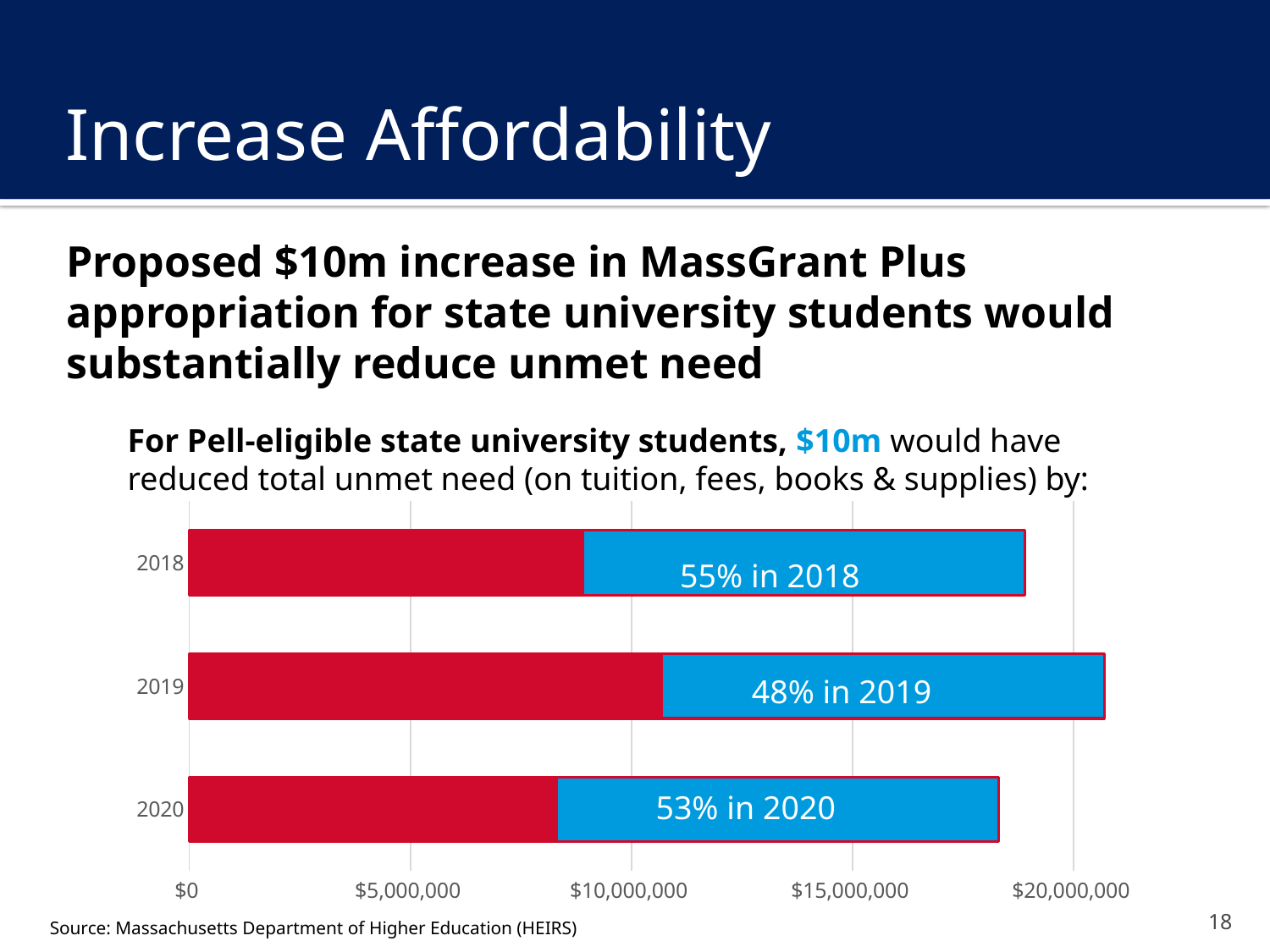
How many years are plotted in the chart? 3 Which year has the highest labelled percentage reduction? 2018 Which year has the lowest labelled percentage reduction? 2019 Is the red segment for 2020 greater or less than $10,000,000? less What percentage reduction in unmet need is labelled for 2019? 48% What is the highest value shown on the horizontal axis? $20,000,000 What percentage reduction in unmet need is labelled for 2018? 55% What percentage reduction in unmet need is labelled for 2020? 53% What kind of chart is shown on the slide? bar chart Is the total bar for 2018 greater or less than $20,000,000? less Which year has the longest total bar? 2019 Is the total bar for 2019 greater or less than $20,000,000? greater